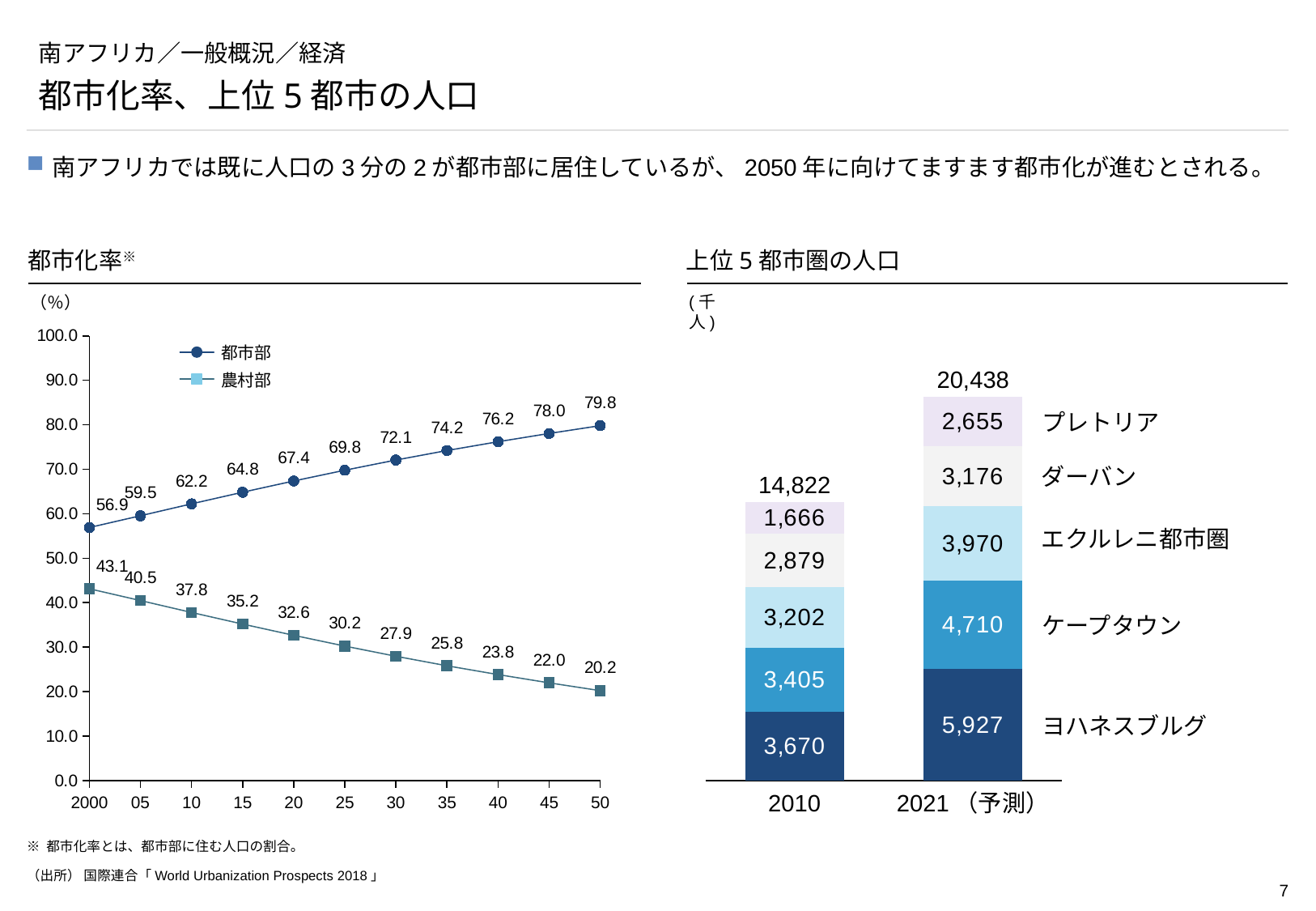
In the 上位5都市圏の人口 chart, what is the total for the 2010 bar? 14,822 In the 都市化率 chart, what is the value for 農村部 in 2050? 20.2 In the 都市化率 chart, what is the value for 都市部 in 2000? 56.9 In the 上位5都市圏の人口 chart, what is the value for ケープタウン in 2021 (予測)? 4,710 What kind of chart is the 上位5都市圏の人口 chart? stacked bar chart In the 都市化率 chart, does the 農村部 series rise or fall from 2000 to 2050? fall In the 都市化率 chart, what is the difference between the 都市部 and 農村部 values in 2050? 59.6 In the 都市化率 chart, how many data points are plotted for the 都市部 series? 11 In the 都市化率 chart, how many series does the legend list? 2 In the 都市化率 chart, what is the value for 都市部 in 2025? 69.8 In the 上位5都市圏の人口 chart, which city has the largest segment in 2010? ヨハネスブルグ In the 上位5都市圏の人口 chart, what is the difference between the ヨハネスブルグ values in 2021 (予測) and 2010? 2,257